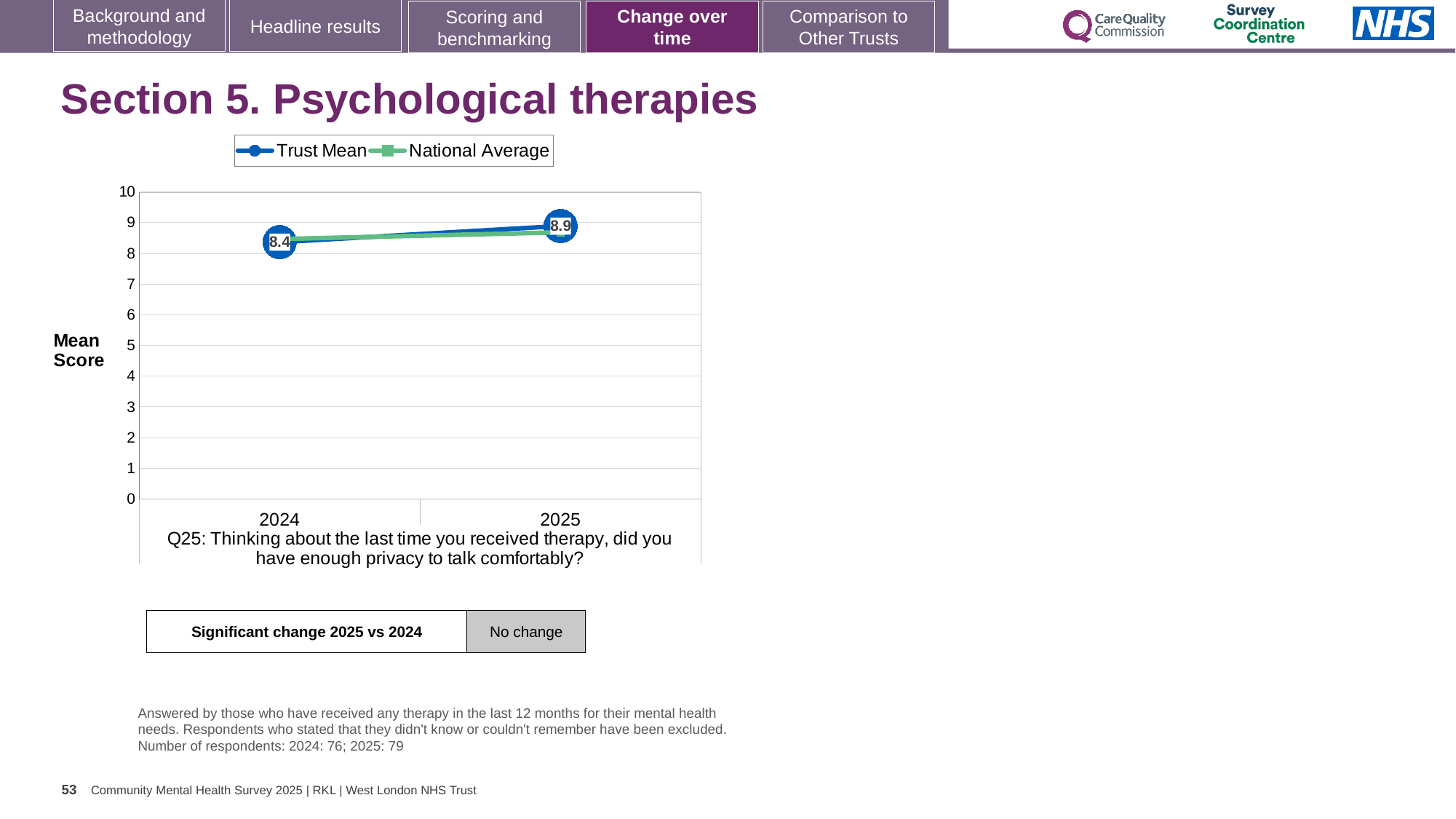
What kind of chart is shown on the slide? line chart What is the Trust Mean score for 2025? 8.9 How many series does the legend list? 2 Does the Trust Mean score rise or fall from 2024 to 2025? rise In which year is the Trust Mean score highest? 2025 Is the National Average value for 2025 greater or less than 8? greater What is the label on the y axis of the chart? Mean Score How many years are plotted on the x axis? 2 Which year has the higher Trust Mean score, 2024 or 2025? 2025 What is the Trust Mean score for 2024? 8.4 By how much did the Trust Mean score change from 2024 to 2025? 0.5 Is the National Average value for 2024 greater or less than 9? less